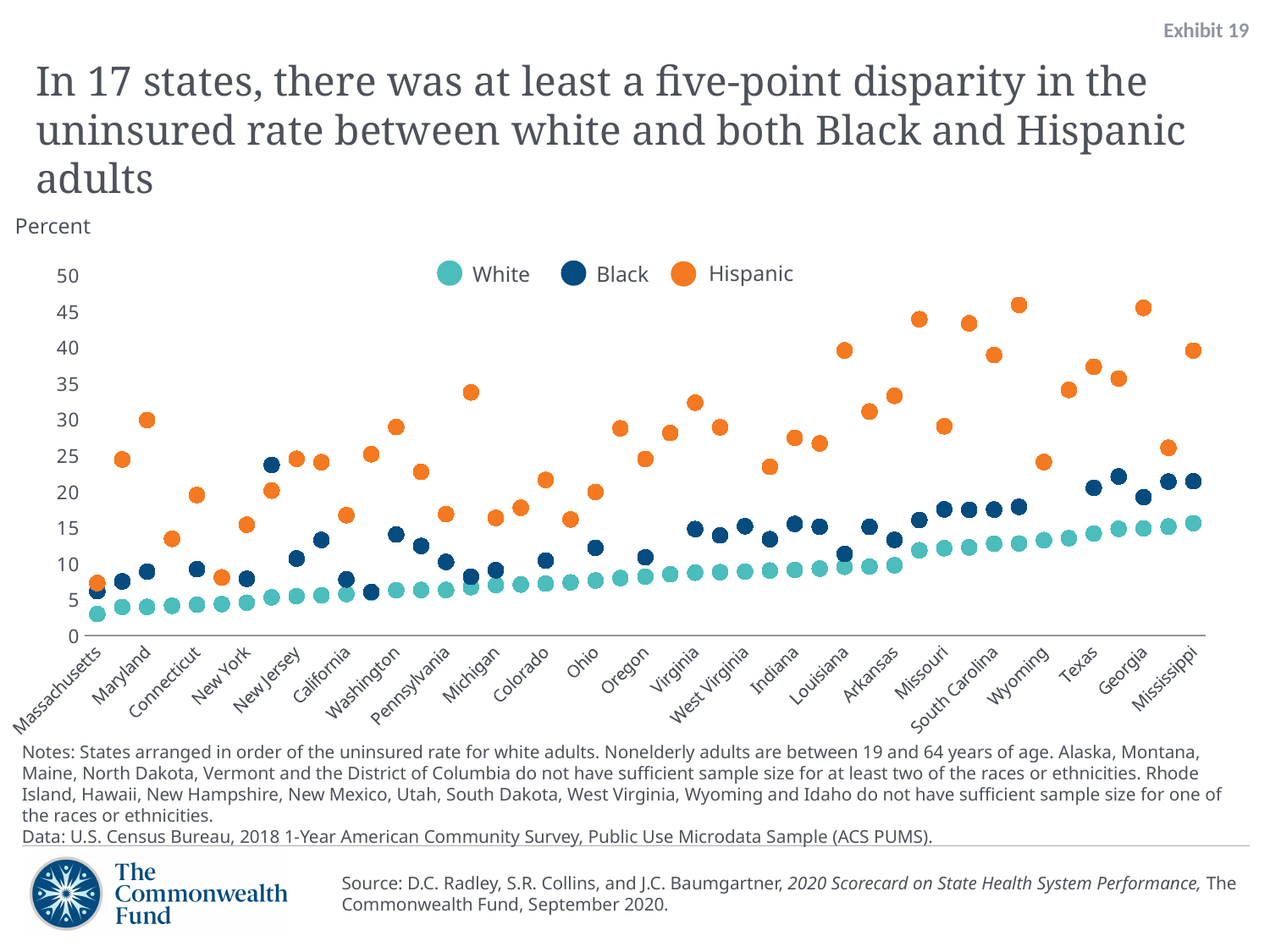
Which state has the lowest uninsured rate for white adults? Massachusetts Is the Hispanic value for Wyoming greater or less than 20? greater Do the values for the White series rise or fall moving from left to right along the x axis? Rise Is the Hispanic value for Arkansas greater or less than 30? greater Is the Hispanic value for Massachusetts greater or less than 10? less What kind of chart is shown on the slide? Scatter (dot) chart In Georgia, which is larger: the Hispanic value or the White value? Hispanic Which series is shown in orange? Hispanic How many series does the legend list? 3 Which state has the highest uninsured rate for white adults? Mississippi